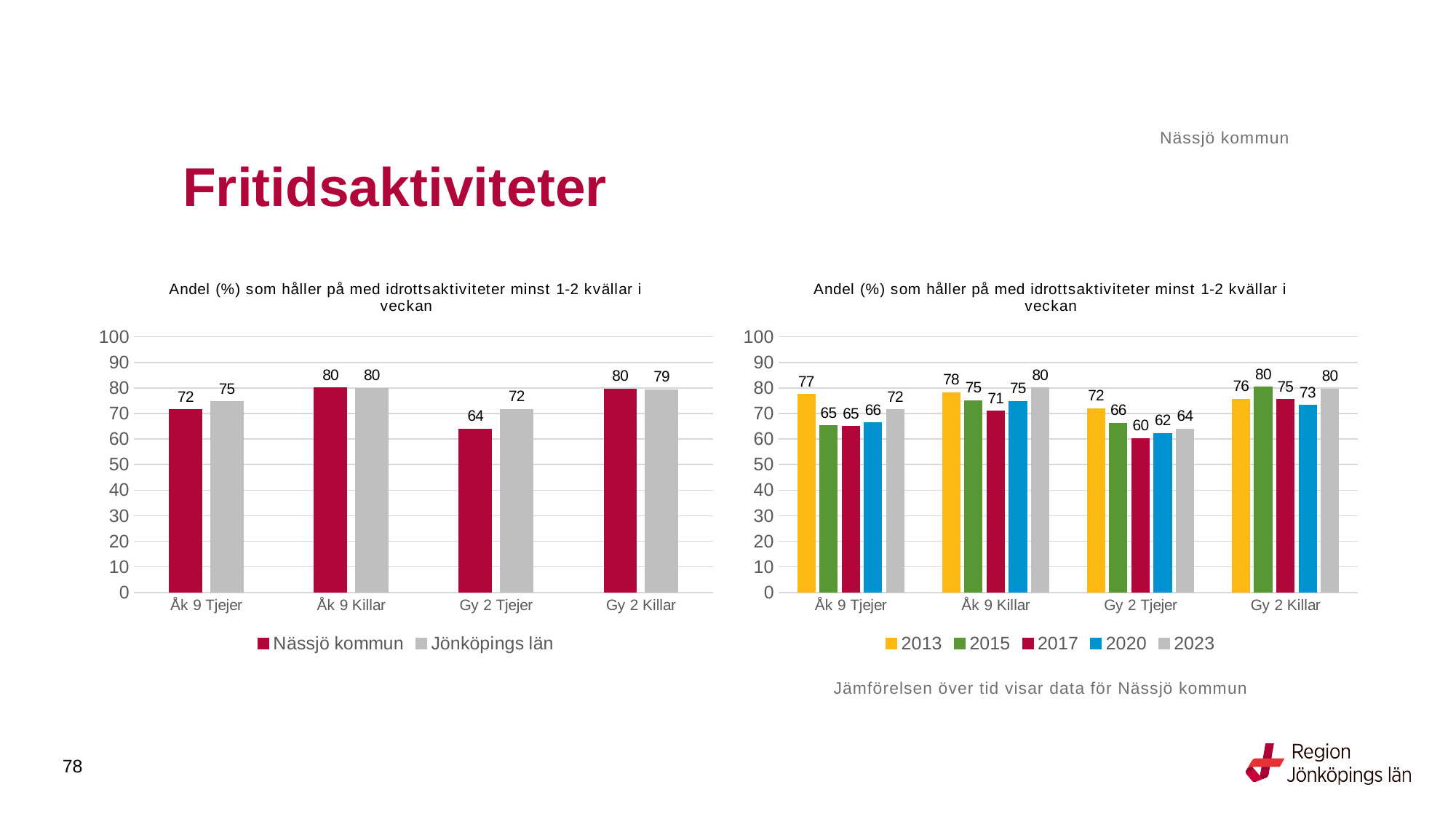
In the right chart, what is the value for 2017 for Gy 2 Tjejer? 60 In the right chart, what is the difference between the 2013 and 2017 values for Åk 9 Tjejer? 12 In the left chart, what is the value for Jönköpings län for Åk 9 Tjejer? 75 In the right chart, which year has the highest value for Åk 9 Tjejer? 2013 In the left chart, what is the difference between Jönköpings län and Nässjö kommun for Gy 2 Tjejer? 8 In the left chart, which category has the lowest value for Nässjö kommun? Gy 2 Tjejer In the right chart, what is the value for 2023 for Åk 9 Killar? 80 In the left chart, what is the value for Nässjö kommun for Gy 2 Tjejer? 64 In the right chart, how many series does the legend list? 5 What kind of chart is the left chart? Bar chart In the left chart, how many series does the legend list? 2 In the right chart, is the value for 2013 larger or the value for 2023 for Gy 2 Killar? 2023